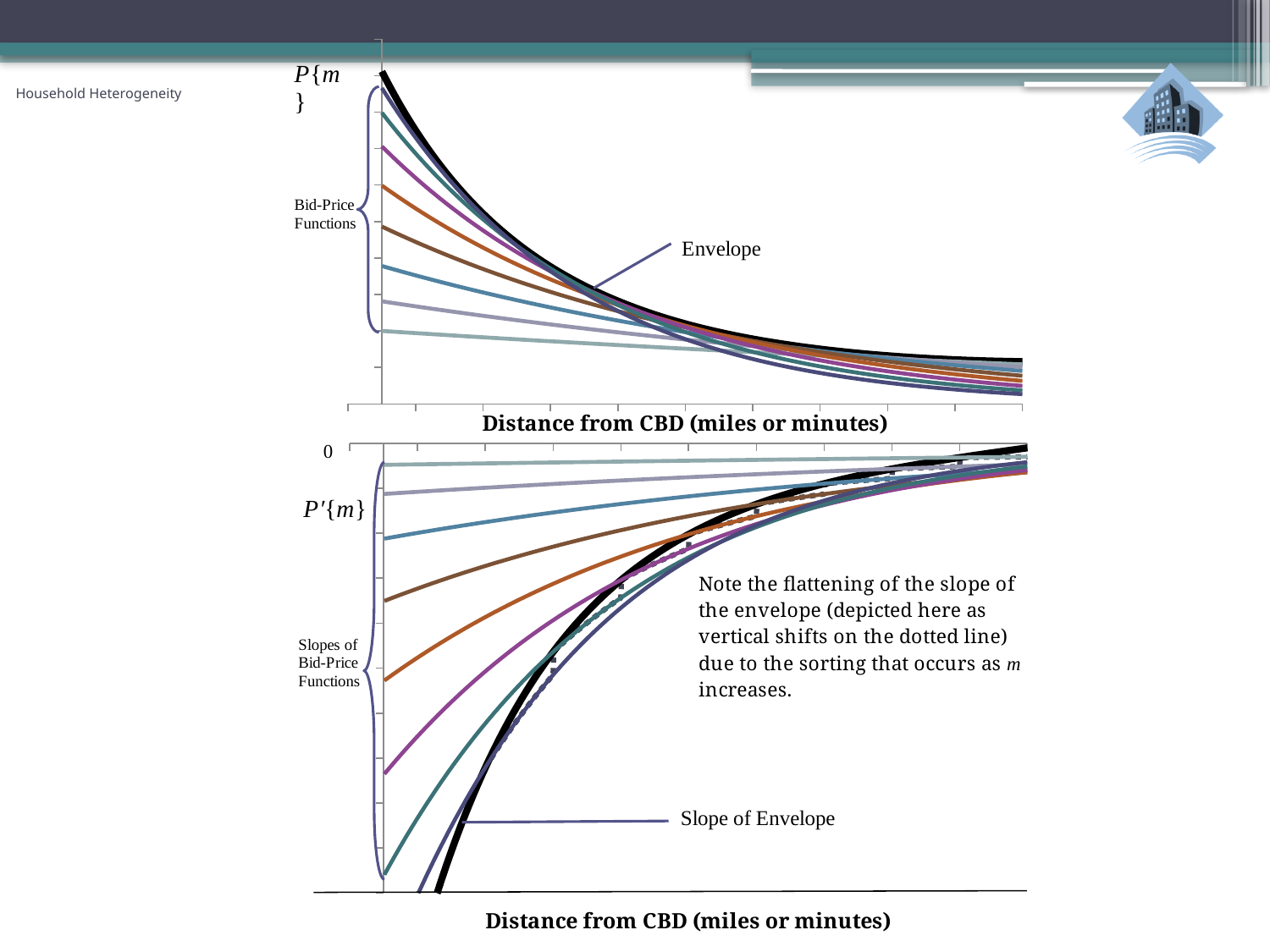
In the bottom chart, is the value of the slope of the envelope near the left edge greater or less than 0? less In the top chart, how many coloured bid-price function curves are plotted (excluding the black envelope)? 8 What kind of chart is the top chart (P{m} versus distance from CBD)? Line chart What kind of chart is the bottom chart (P'{m} versus distance from CBD)? Line chart In the bottom chart, do the slope curves rise or fall as distance from the CBD increases? Rise In the bottom chart, how many coloured slope curves are plotted (excluding the black slope-of-envelope curve)? 8 In the top chart, do the bid-price function curves rise or fall as distance from the CBD increases? Fall In the top chart, what does the thick black curve represent according to its label? Envelope What is the x-axis label of the bottom chart? Distance from CBD (miles or minutes)